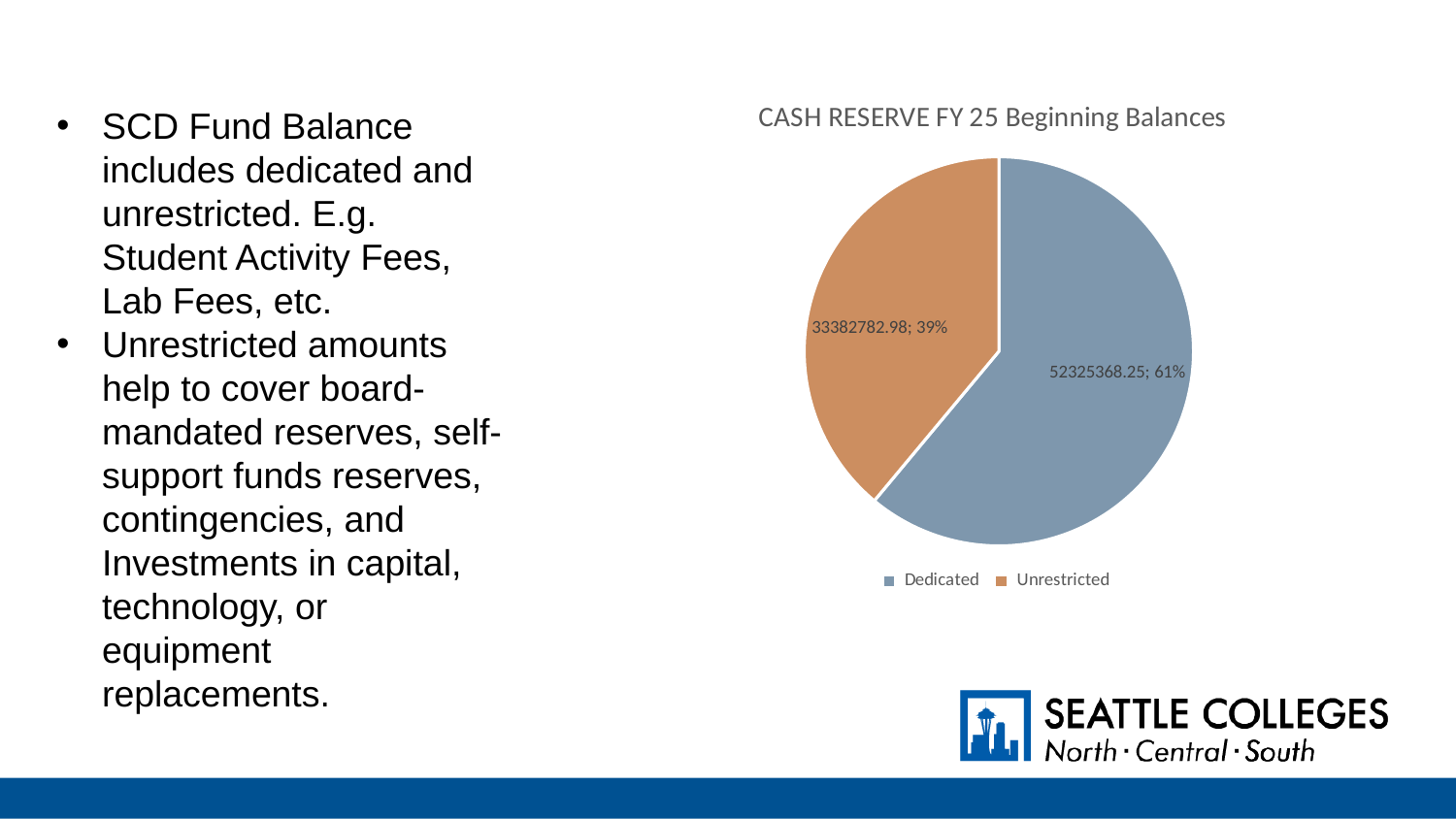
What is the value for Unrestricted in the pie chart? 33382782.98 Which colour represents Unrestricted in the pie chart? Orange Which category has the largest slice in the pie chart? Dedicated Which category has the smallest slice in the pie chart? Unrestricted What is the difference between the Dedicated and Unrestricted values? 18942585.27 Which is larger, the Dedicated value or the Unrestricted value? Dedicated What share of the pie does the Unrestricted slice represent? 39% How many categories does the pie chart show? 2 What is the title of the chart? CASH RESERVE FY 25 Beginning Balances What is the value for Dedicated in the pie chart? 52325368.25 What type of chart is shown on the slide? Pie chart What share of the pie does the Dedicated slice represent? 61%